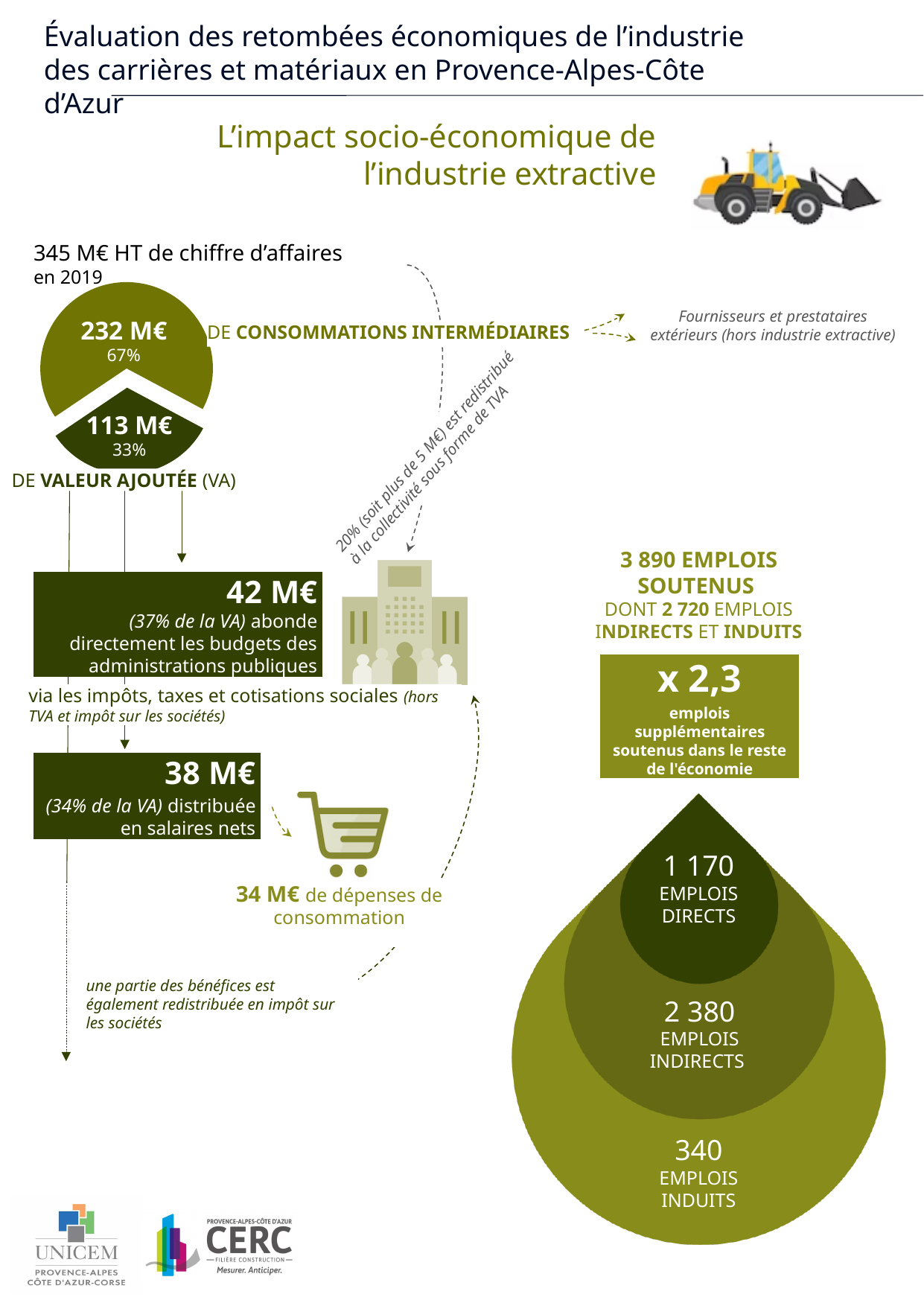
What kind of chart is used on the left to split the 345 M€ of chiffre d'affaires? Pie chart In the pie chart on the left, which slice is larger: 'consommations intermédiaires' or 'valeur ajoutée'? Consommations intermédiaires In the pie chart on the left, what value is shown for the 'valeur ajoutée' (VA) slice? 113 M€ In the pie chart on the left, what share of the total does the 'valeur ajoutée' represent? 33% In the pie chart on the left, what is the difference between the 'consommations intermédiaires' value and the 'valeur ajoutée' value? 119 M€ In the pie chart on the left, what share of the total do the 'consommations intermédiaires' represent? 67% In the nested circle chart on the bottom right, what is the difference between 'emplois indirects' and 'emplois directs'? 1 210 How many slices does the pie chart on the left have? 2 In the nested circle chart on the bottom right, how many 'emplois indirects' are shown? 2 380 In the nested circle chart on the bottom right, which employment category has the lowest value? Emplois induits In the nested circle chart on the bottom right, how many 'emplois directs' are shown? 1 170 In the pie chart on the left, what value is shown for the 'consommations intermédiaires' slice? 232 M€